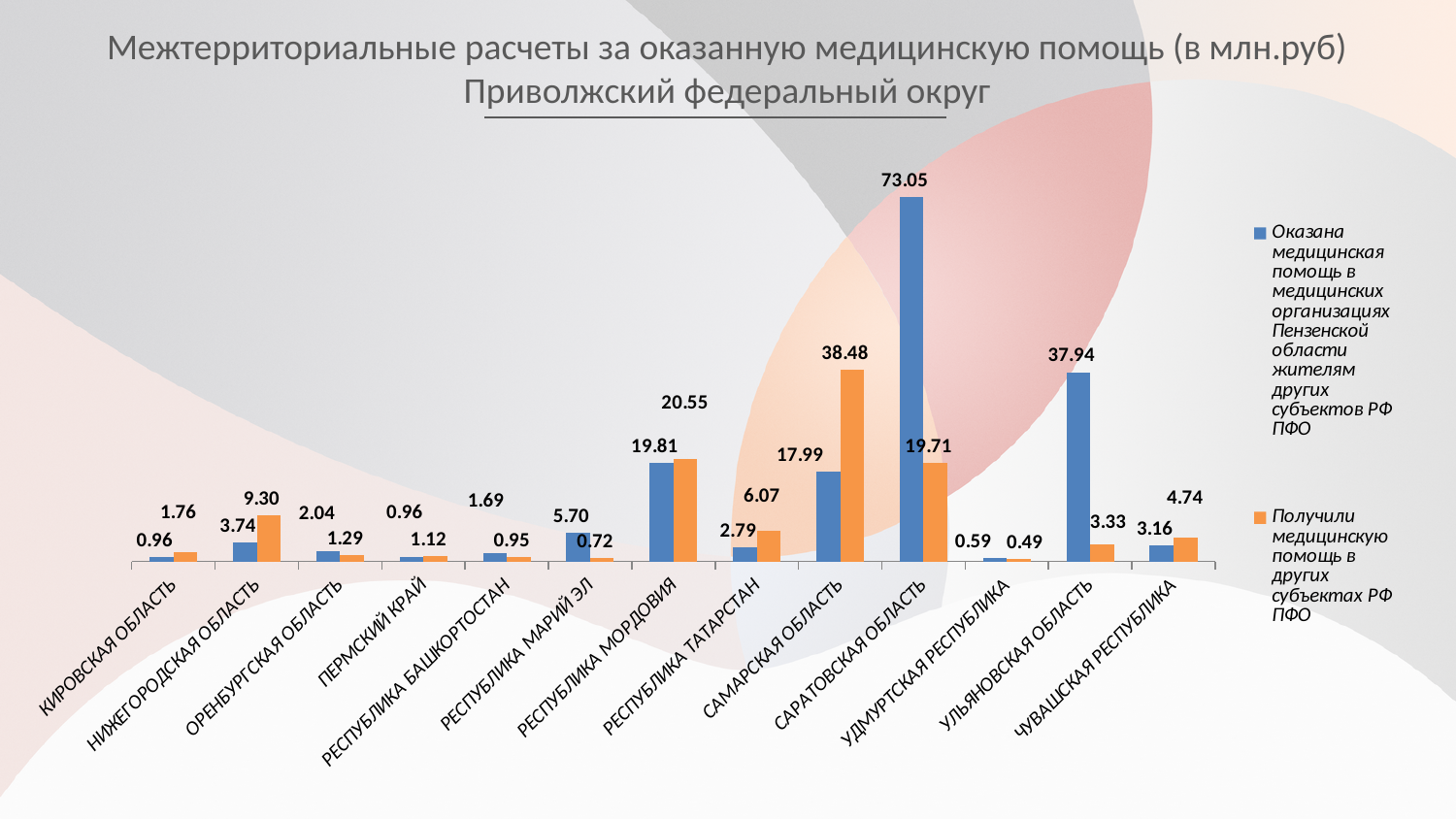
Which region has the highest value in the blue series (Оказана медицинская помощь)? Саратовская область What unit is stated in the chart title for the values? млн.руб How many regions (categories) are shown on the x axis? 13 What is the difference between the orange and blue values for Республика Мордовия? 0.74 For Ульяновская область, which is larger: the blue series value or the orange series value? Blue series (37.94) Which region has the lowest value in the orange series (Получили медицинскую помощь)? Удмуртская республика How many series does the legend list? 2 What is the value of the blue series (Оказана медицинская помощь в медицинских организациях Пензенской области) for Саратовская область? 73.05 What is the difference between the blue and orange values for Саратовская область? 53.34 What type of chart is shown on the slide? Bar chart What is the value of the orange series for Нижегородская область? 9.30 What is the value of the orange series (Получили медицинскую помощь в других субъектах РФ ПФО) for Самарская область? 38.48